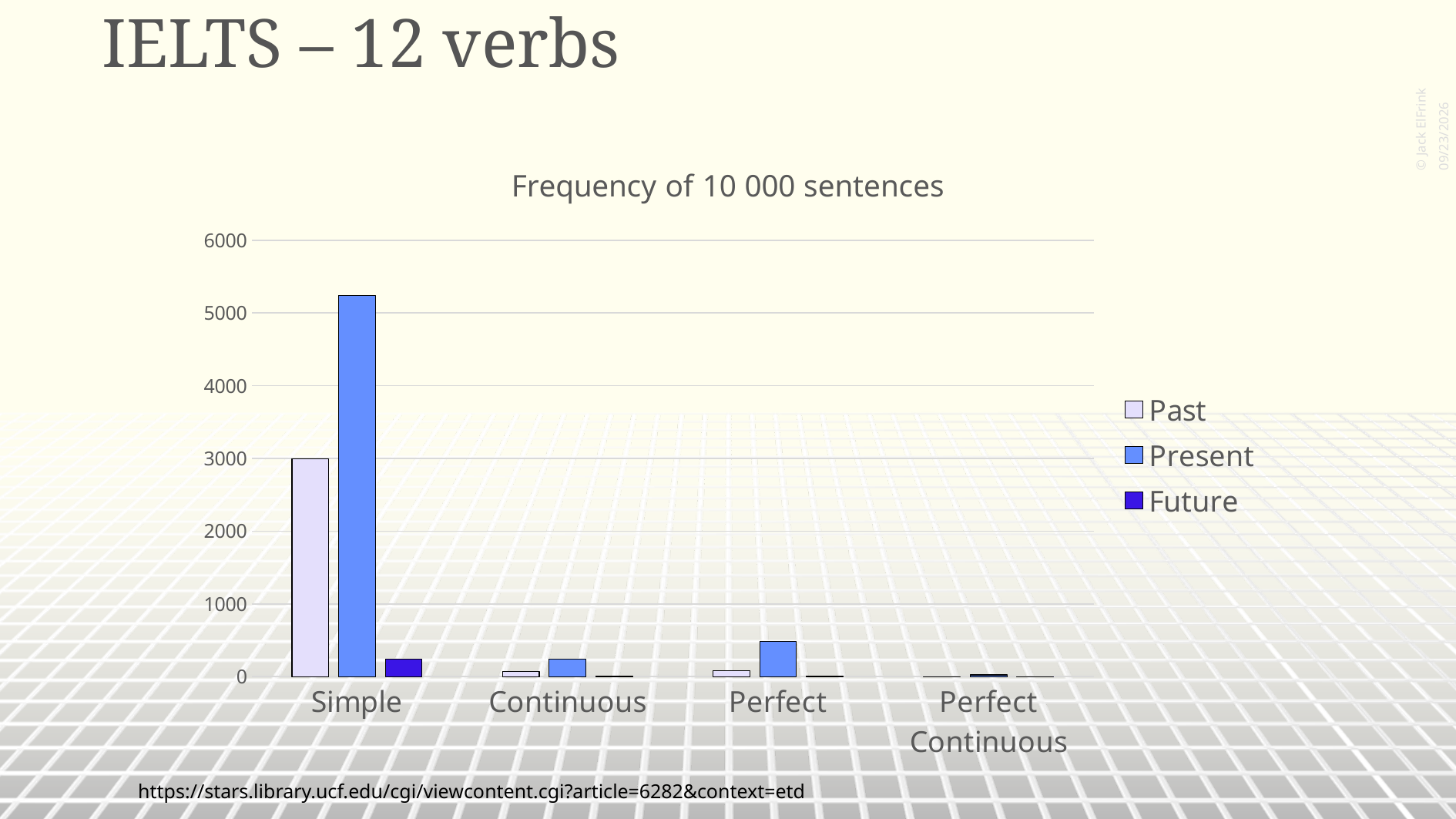
How many series does the legend list? 3 Which is larger, the Present value for Perfect or the Present value for Continuous? Perfect Is the Present value for Simple greater or less than 5000? greater What kind of chart is shown on the slide? bar chart Which series is shown in the darkest blue colour in the legend? Future Is the Past value for Simple greater or less than 2000? greater How many categories are shown on the x axis? 4 Is the Present value for Perfect greater or less than 1000? less Which is larger, the Past value for Simple or the Future value for Simple? Past Which series has the highest bar in the Simple category? Present What is the title of the chart? Frequency of 10 000 sentences Which category has the highest Present value? Simple